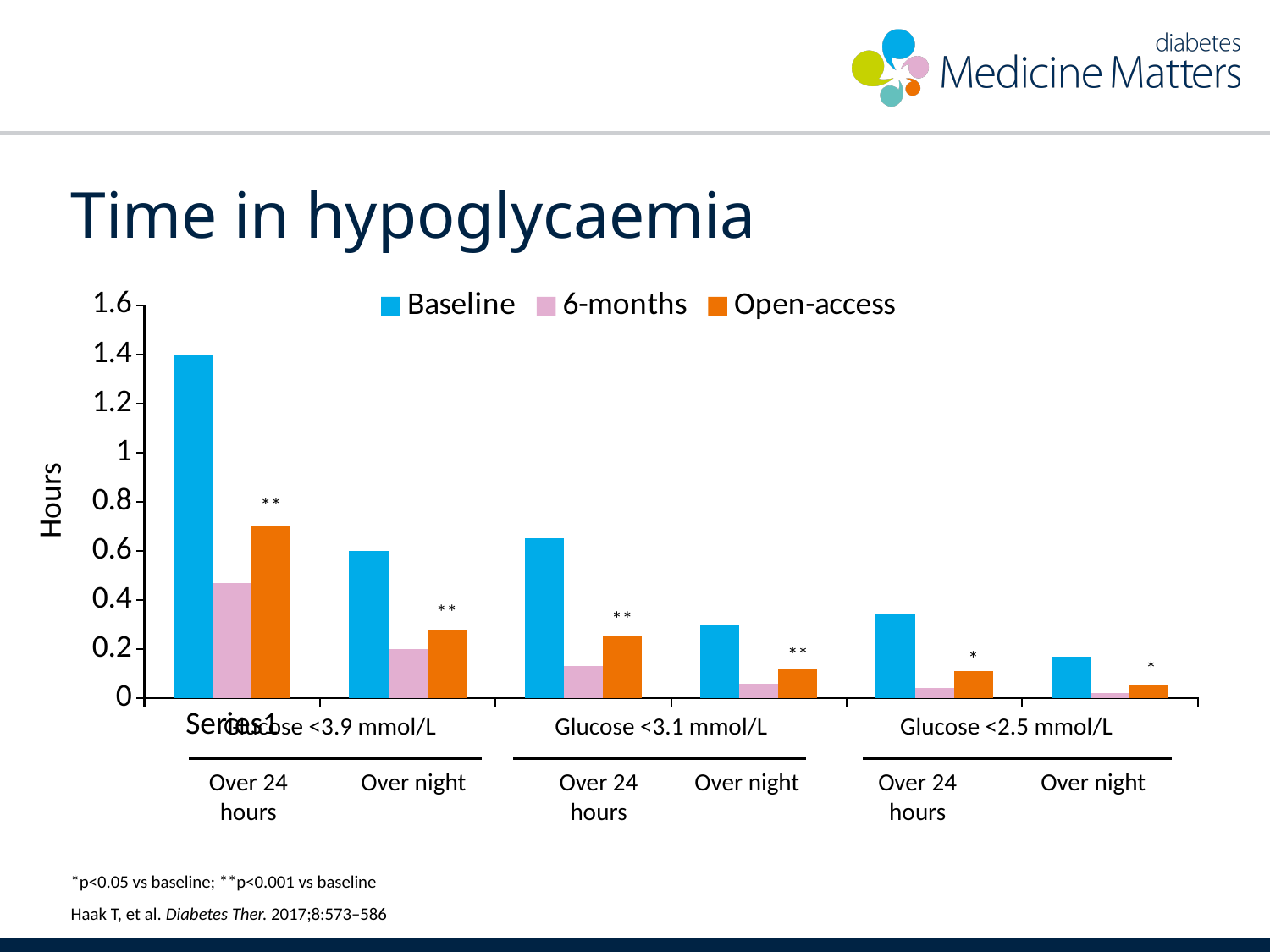
What kind of chart is shown on the slide? Bar chart What is the Baseline value for Glucose <3.9 mmol/L over 24 hours? 1.4 For Glucose <3.9 mmol/L over 24 hours, which is larger: the Baseline value or the Open-access value? Baseline Is the Baseline value for Glucose <3.1 mmol/L over 24 hours greater or less than 0.8? less Which bar is the lowest on the chart? 6-months, Glucose <2.5 mmol/L over night For Glucose <3.9 mmol/L over 24 hours, which is larger: the 6-months value or the Open-access value? Open-access What is the label on the vertical axis? Hours Which bar is the highest on the chart? Baseline, Glucose <3.9 mmol/L over 24 hours Is the Open-access value for Glucose <3.9 mmol/L over 24 hours greater or less than 0.6? greater How many series does the legend list? 3 What are the three series named in the legend? Baseline, 6-months, Open-access What is the Baseline value for Glucose <3.9 mmol/L over night? 0.6